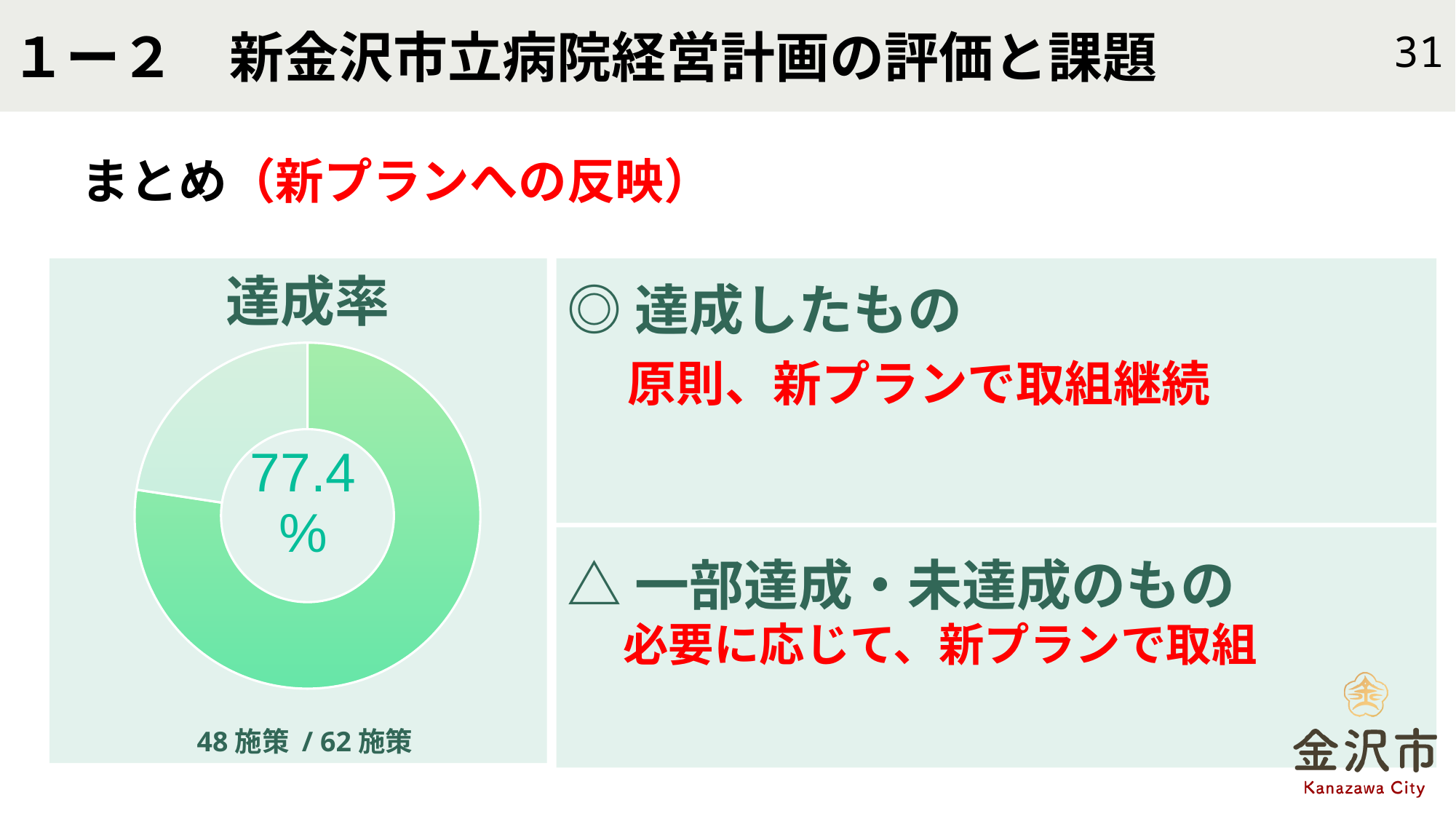
What kind of chart is shown on the slide? donut (pie) chart What share of the donut does the larger (darker green) slice represent? 77.4% Which slice of the donut chart is larger, the darker green one or the lighter green one? the darker green one How many slices does the donut chart have? 2 What percentage is printed in the centre of the donut chart? 77.4% What is the title of the chart on the slide? 達成率 Based on the figures printed below the chart, how many measures were not achieved (62 minus 48)? 14 What text is printed directly below the donut chart? 48 施策 / 62 施策 According to the text below the chart, how many measures (施策) were achieved? 48 施策 Does the larger slice of the donut chart cover more or less than half of the circle? more According to the text below the chart, what is the total number of measures (施策)? 62 施策